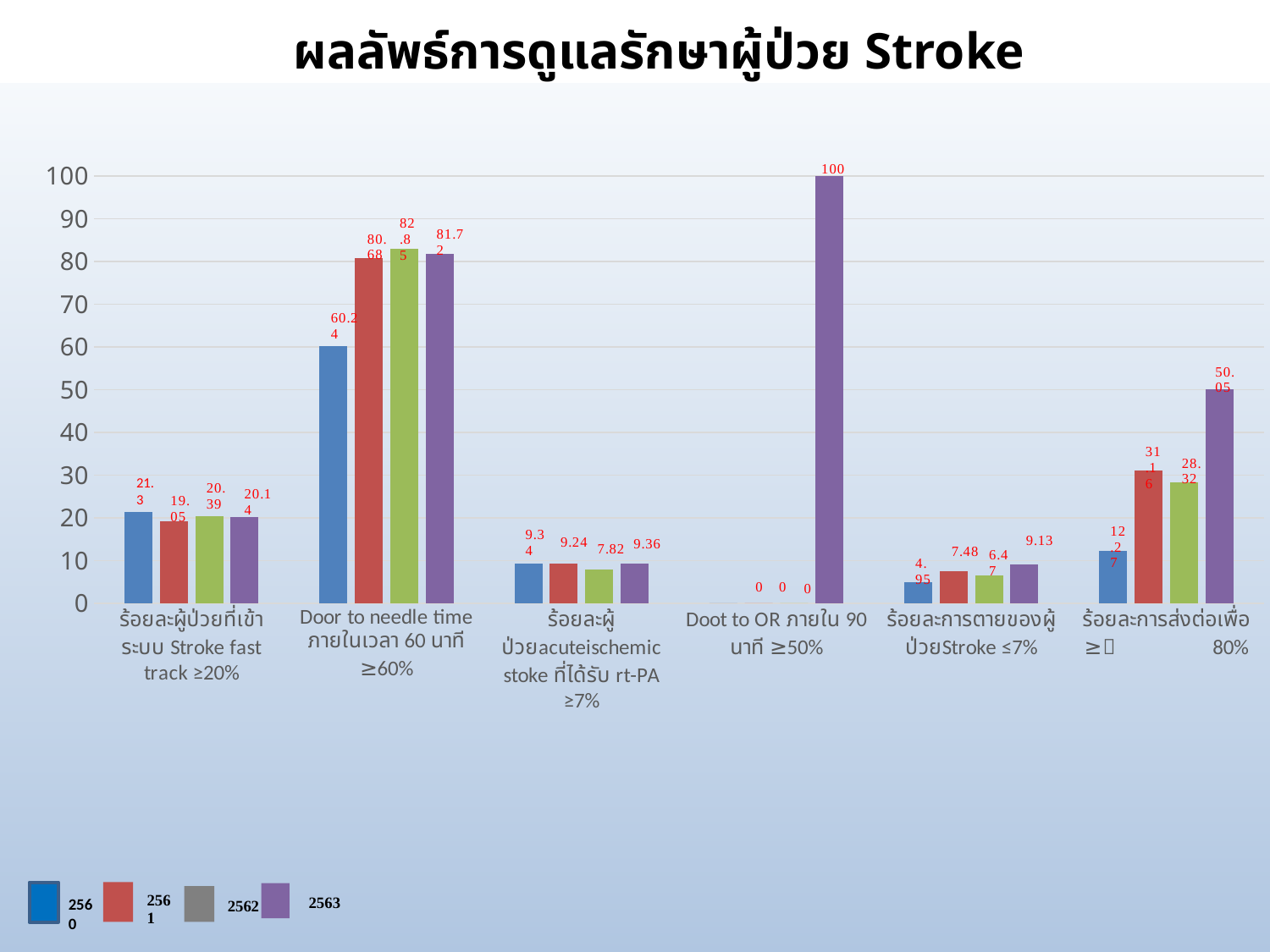
Which year has the highest value in the category "ร้อยละการส่งต่อเพื่อ ≥ 80%"? 2563 What is the value for 2562 in the category "ร้อยละผู้ป่วยacuteischemic stoke ที่ได้รับ rt-PA ≥7%"? 7.82 Which year has the lowest value in the category "Door to needle time ภายในเวลา 60 นาที ≥60%"? 2560 Is the value for 2560 in the category "Door to needle time ภายในเวลา 60 นาที ≥60%" greater or less than 50? greater How many categories are shown on the x axis of the chart? 6 What kind of chart is shown on the slide? bar chart What is the difference between the 2563 and 2562 values in the category "ร้อยละการส่งต่อเพื่อ ≥ 80%"? 21.73 What is the value for 2563 in the category "ร้อยละการตายของผู้ป่วยStroke ≤7%"? 9.13 How many series does the legend list? 4 In the category "Door to needle time ภายในเวลา 60 นาที ≥60%", which is larger: the value for 2561 or for 2563? 2563 What is the value for 2563 in the category "Doot to OR ภายใน 90 นาที ≥50%"? 100 What is the value for 2560 in the category "Doot to OR ภายใน 90 นาที ≥50%"? 0